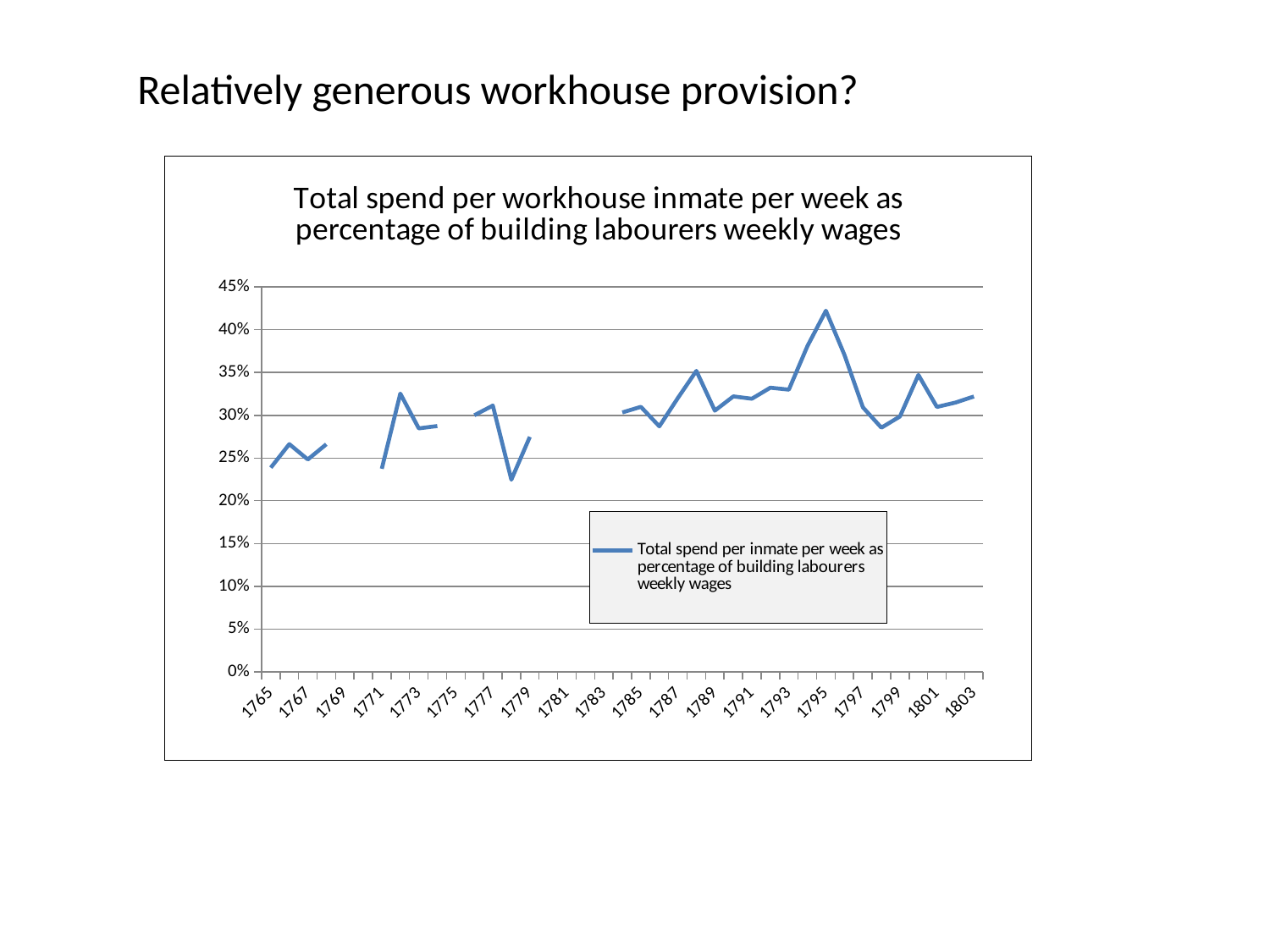
Which year has the larger value, 1771 or 1772? 1772 Is the value for 1779 greater or less than 25%? greater Is the value for 1795 greater or less than 40%? greater What is the title of the chart? Total spend per workhouse inmate per week as percentage of building labourers weekly wages Does the line rise or fall between 1795 and 1798? fall Is the value for 1803 greater or less than 30%? greater What kind of chart is shown on the slide? line chart In which year does the line reach its highest value? 1795 How many year labels are shown on the x axis? 20 How many series does the legend list? 1